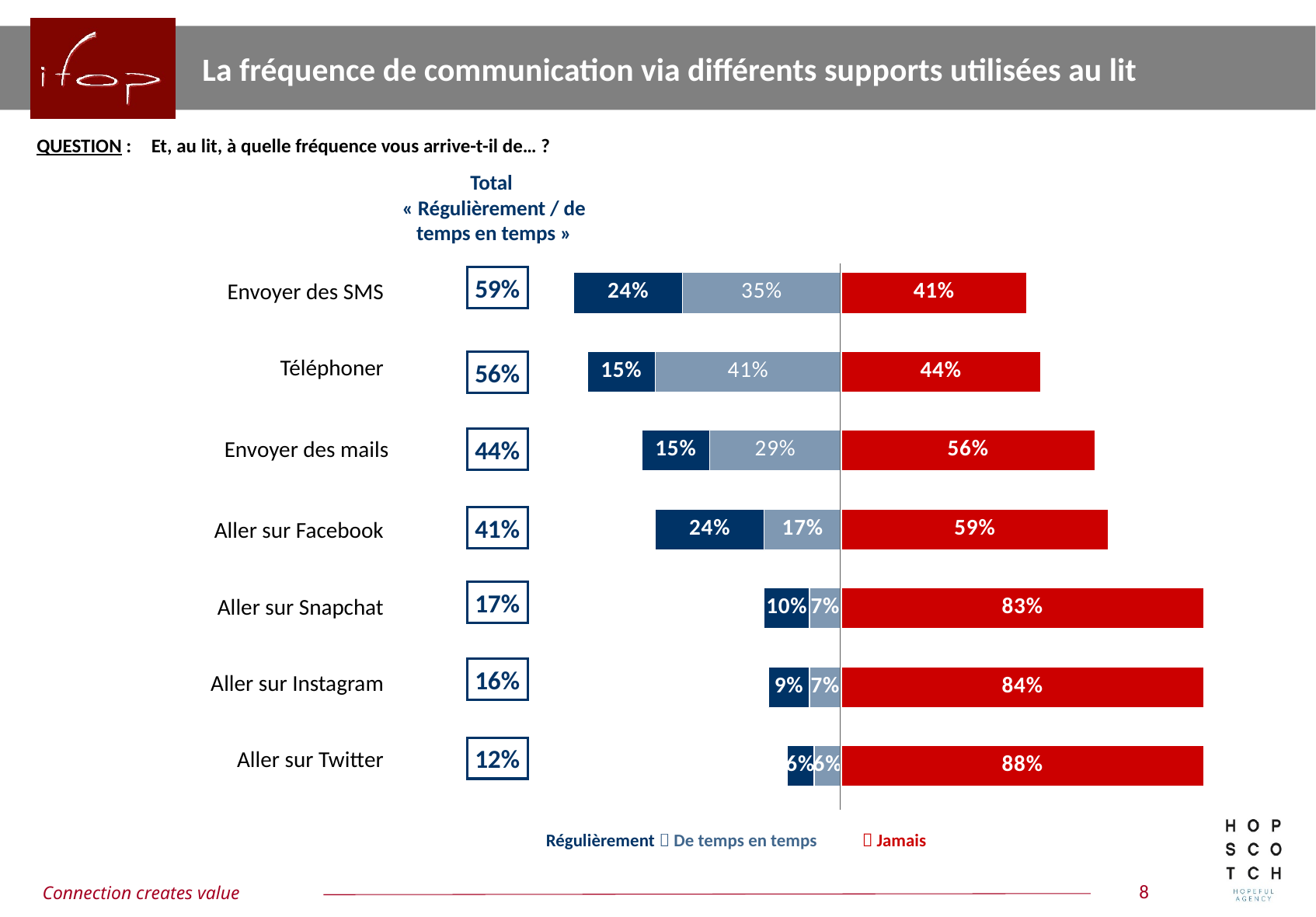
Which is larger: the 'Régulièrement' value for 'Envoyer des SMS' or for 'Téléphoner'? Envoyer des SMS What is the difference between the 'Jamais' values for 'Aller sur Snapchat' and 'Envoyer des mails'? 27% What is the 'De temps en temps' value for 'Téléphoner'? 41% What is the total 'Régulièrement / de temps en temps' value shown for 'Envoyer des mails'? 44% Which activity has the highest 'Jamais' value? Aller sur Twitter Which activity has the lowest 'Jamais' value? Envoyer des SMS What percentage of respondents say they 'Jamais' (never) send SMS in bed? 41% How many activities (categories) are shown in the chart? 7 Which colour represents the 'Jamais' series in the chart? Red How many series does the legend list? 3 What kind of chart is shown on the slide? Stacked bar chart What is the 'Régulièrement' value for 'Aller sur Facebook'? 24%